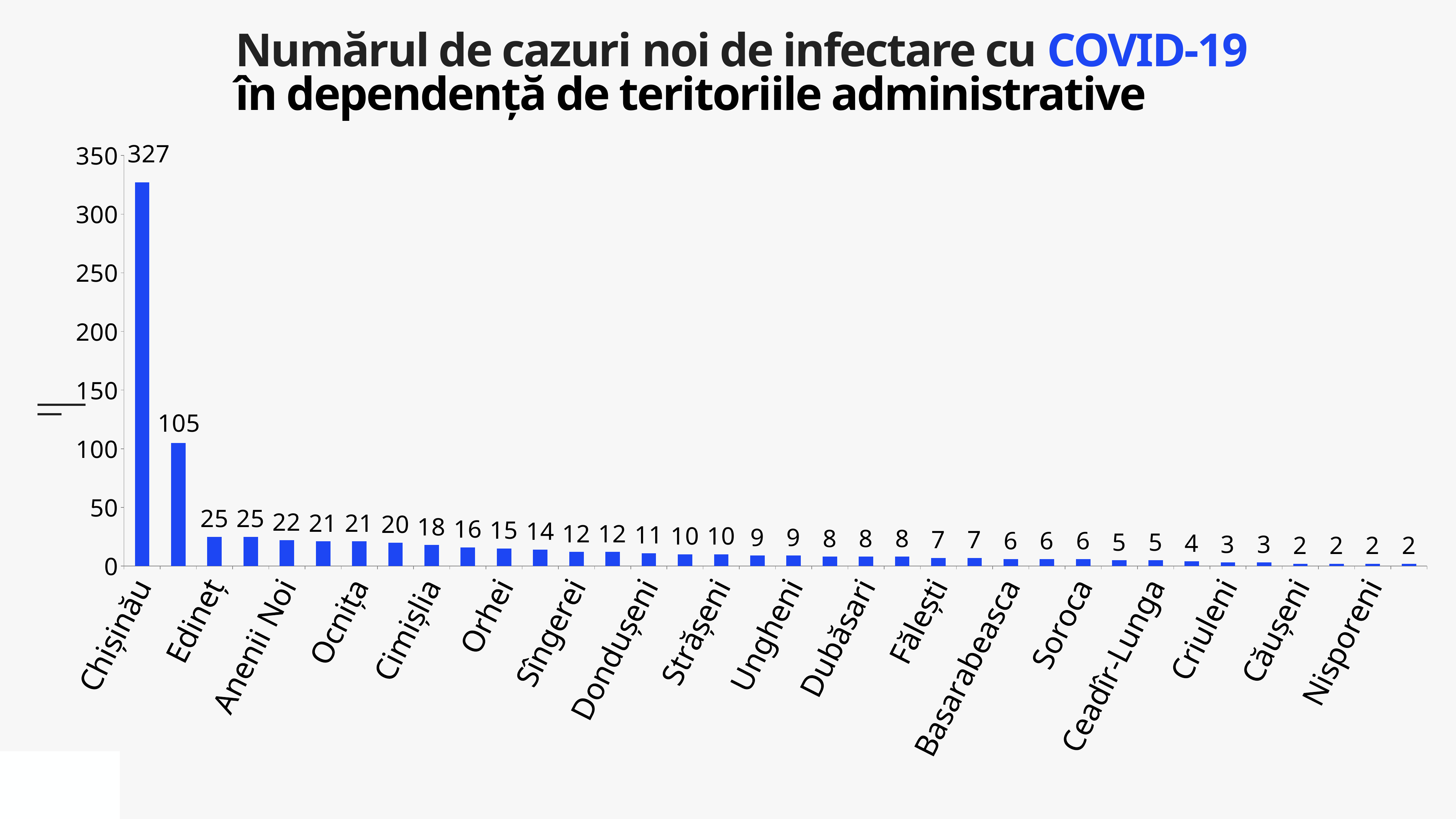
What is the value for Criuleni? 3 How many bars are plotted in the chart? 36 What is the difference between the highest value (327) and the second-highest value (105)? 222 What is the value for Dubăsari? 8 Is the value for Chișinău greater or less than 300? greater What is the value for Sîngerei? 12 What is the value for Chișinău? 327 Which administrative territory has the highest number of new COVID-19 cases? Chișinău What is the value for Nisporeni? 2 What is the value for Fălești? 7 What type of chart is shown on the slide? bar chart Do the values rise or fall from left to right along the x axis? fall